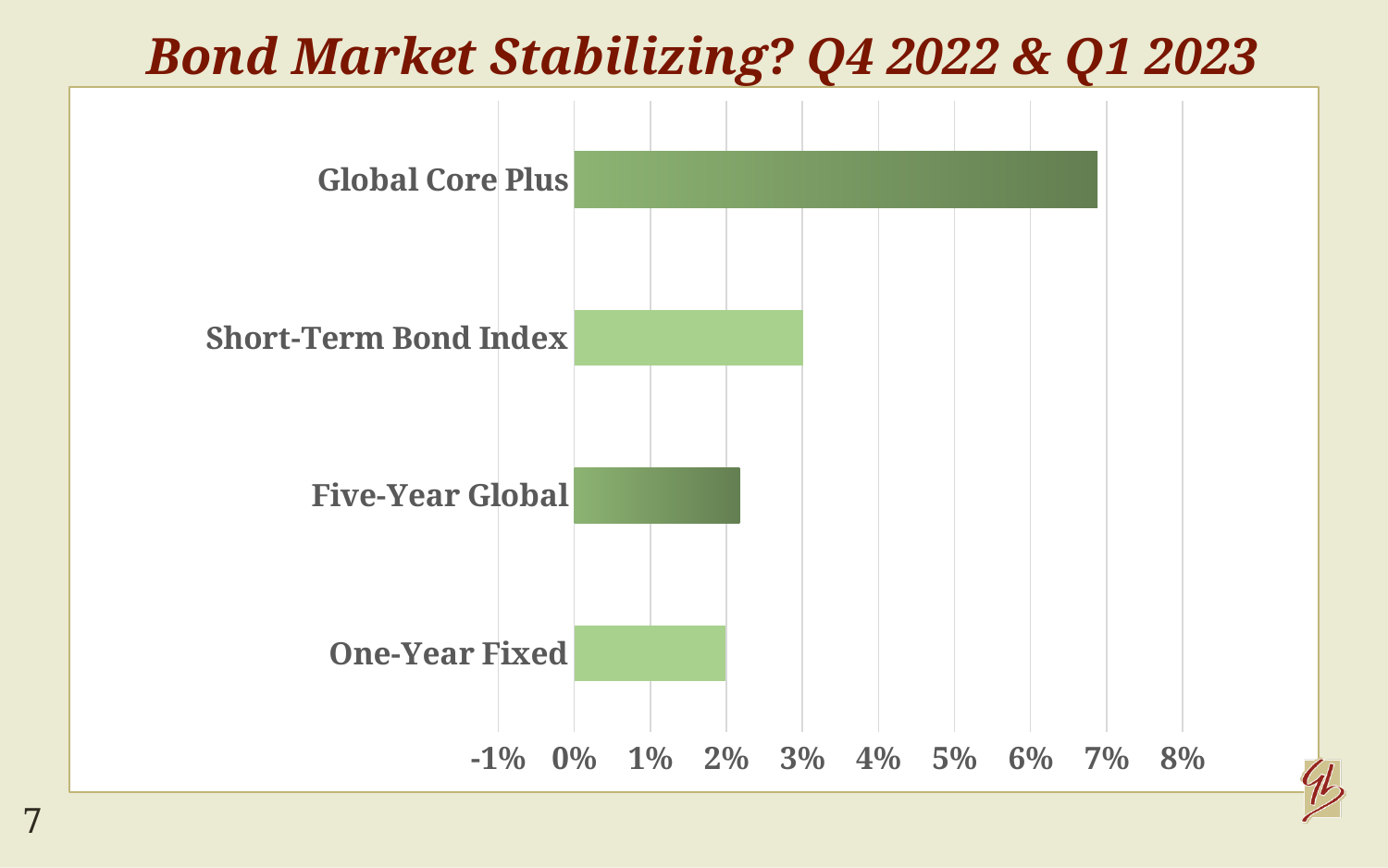
Is the value for Global Core Plus greater or less than 6%? greater Which is larger, the value for Short-Term Bond Index or the value for Five-Year Global? Short-Term Bond Index Which category has the highest value? Global Core Plus Which is larger, the value for Global Core Plus or the value for Short-Term Bond Index? Global Core Plus What is the title of the slide? Bond Market Stabilizing? Q4 2022 & Q1 2023 Is the value for Short-Term Bond Index greater or less than 1%? greater Is the value for Five-Year Global greater or less than 3%? less How many categories are plotted in the chart? 4 What is the lowest tick label shown on the horizontal axis? -1% What kind of chart is shown on the slide? bar chart